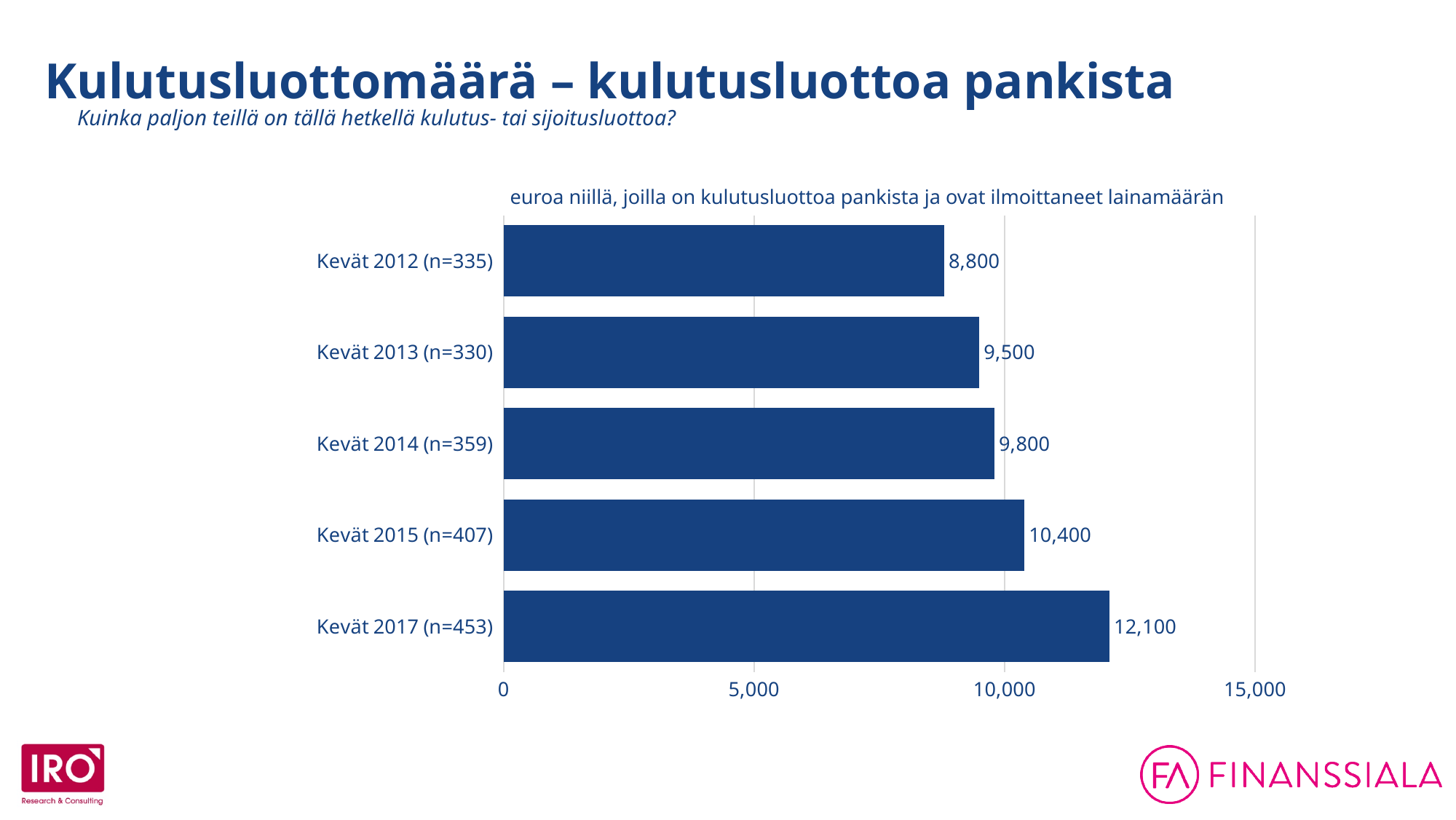
Which category has the highest value? Kevät 2017 (n=453) What is the value for Kevät 2014 (n=359)? 9,800 What is the value for Kevät 2012 (n=335)? 8,800 Which category has the lowest value? Kevät 2012 (n=335) How many categories are shown in the chart? 5 Is the value for Kevät 2014 (n=359) greater or less than 10,000? less What is the difference between the values for Kevät 2015 (n=407) and Kevät 2013 (n=330)? 900 What is the difference between the values for Kevät 2017 (n=453) and Kevät 2012 (n=335)? 3,300 Do the values rise or fall from Kevät 2012 to Kevät 2017? rise What kind of chart is shown on the slide? bar chart What is the value for Kevät 2015 (n=407)? 10,400 Which is larger, the value for Kevät 2013 (n=330) or Kevät 2017 (n=453)? Kevät 2017 (n=453)